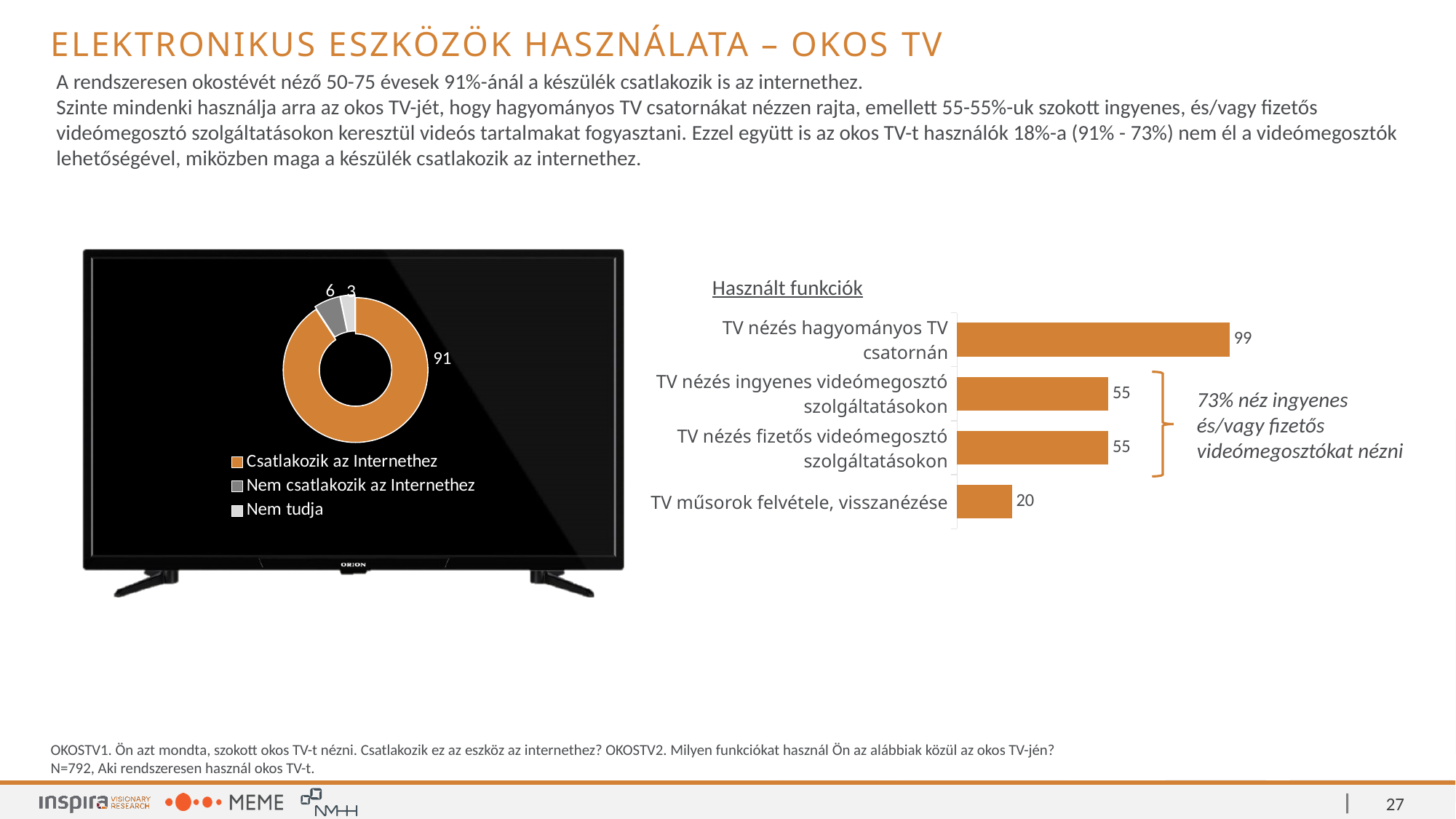
In the doughnut chart on the left, what is the value for "Csatlakozik az Internethez"? 91 In the "Használt funkciók" chart, what is the value for "TV nézés hagyományos TV csatornán"? 99 In the "Használt funkciók" chart, what is the difference between "TV nézés hagyományos TV csatornán" and "TV műsorok felvétele, visszanézése"? 79 In the "Használt funkciók" chart, which category has the highest value? TV nézés hagyományos TV csatornán What kind of chart is the "Használt funkciók" chart? Bar chart In the doughnut chart on the left, what is the value for "Nem tudja"? 3 In the "Használt funkciók" chart, which category has the lowest value? TV műsorok felvétele, visszanézése In the doughnut chart on the left, how many entries does the legend list? 3 In the doughnut chart on the left, which category has the smallest value? Nem tudja In the "Használt funkciók" chart, how many categories are shown? 4 In the "Használt funkciók" chart, what is the value for "TV műsorok felvétele, visszanézése"? 20 In the doughnut chart on the left, what is the value for "Nem csatlakozik az Internethez"? 6